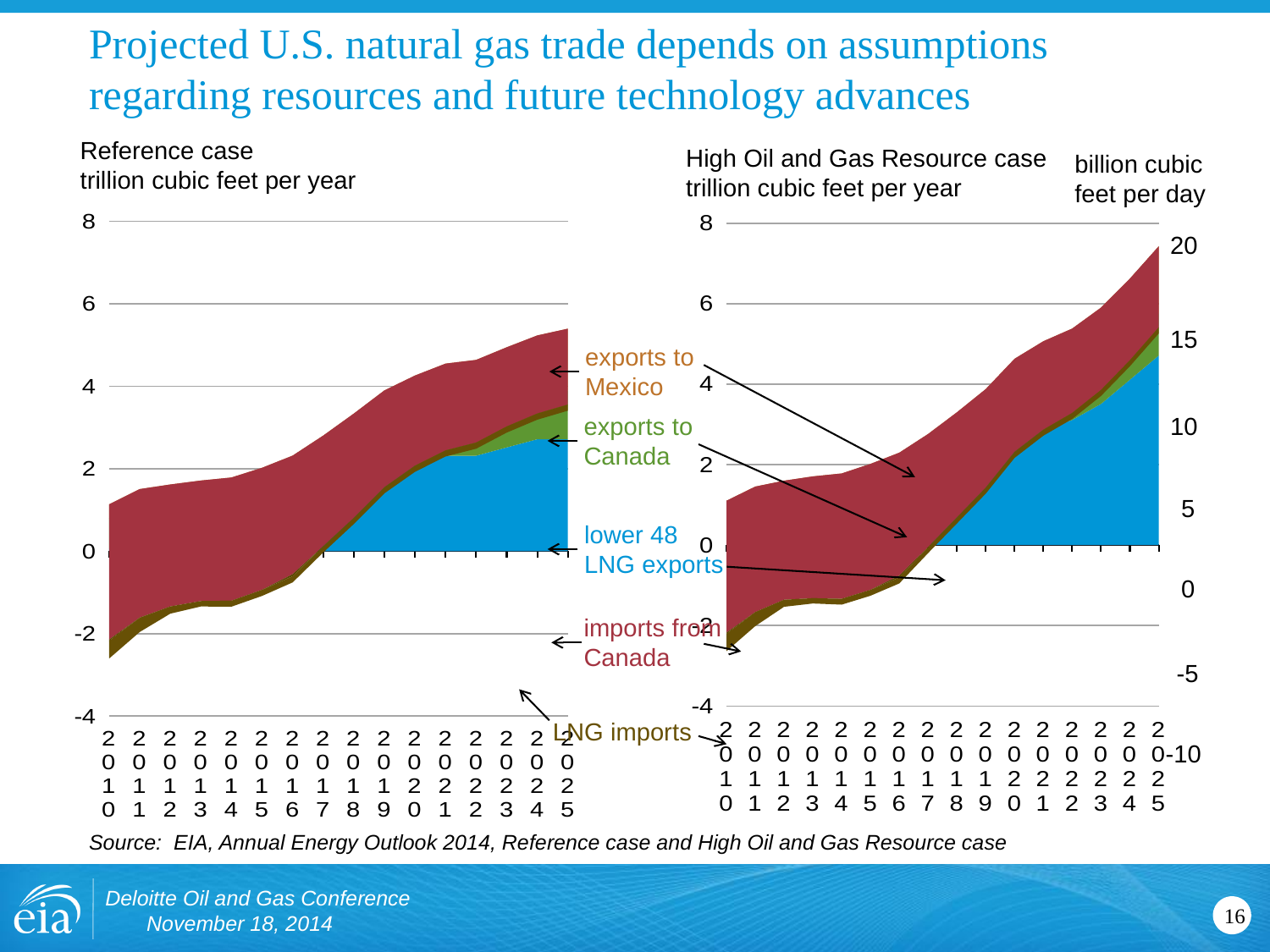
In the Reference case chart, is the total of the export series in 2025 greater or less than 6? less In the Reference case chart, is the value for lower 48 LNG exports in 2025 greater or less than 2? greater In the High Oil and Gas Resource case chart, is the total of the export series in 2025 greater or less than 6? greater What kind of chart is the Reference case chart? stacked area chart In the Reference case chart, does the lower 48 LNG exports series rise or fall from 2015 to 2025? rise In the High Oil and Gas Resource case chart, do total exports rise or fall from 2010 to 2025? rise How many years are shown on the x axis of the Reference case chart? 16 How many series are labeled on the slide's charts? 5 Which chart shows the larger total exports in 2025, the Reference case or the High Oil and Gas Resource case? High Oil and Gas Resource case What unit is shown on the right-hand axis of the High Oil and Gas Resource case chart? billion cubic feet per day What unit is shown on the left axis of the Reference case chart? trillion cubic feet per year